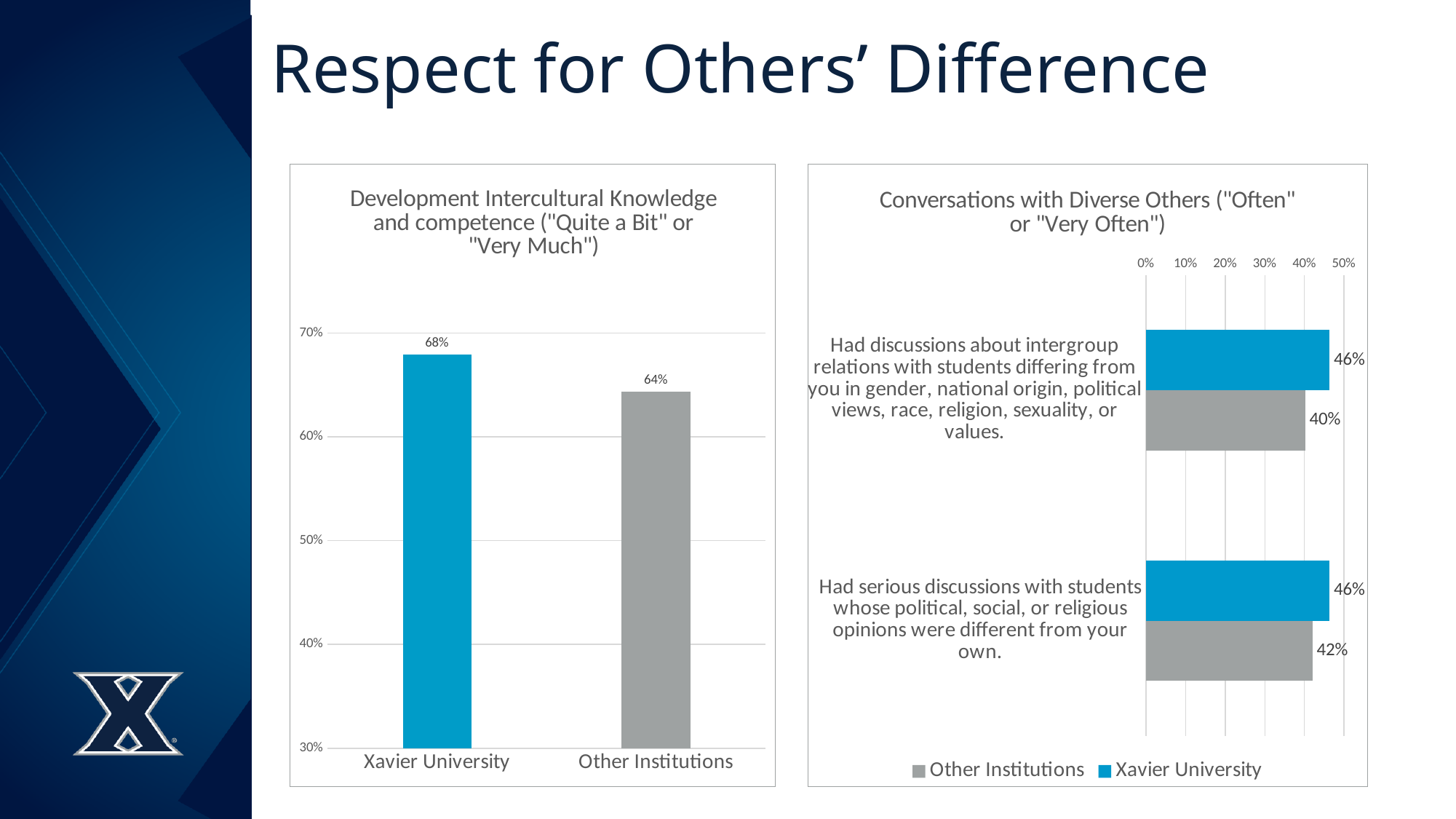
In the right chart (Conversations with Diverse Others), how many series does the legend list? 2 In the right chart (Conversations with Diverse Others), what is the Other Institutions value for 'Had serious discussions with students whose political, social, or religious opinions were different from your own'? 42% In the left chart (Development Intercultural Knowledge and competence), how many categories are shown? 2 In the right chart (Conversations with Diverse Others), which series has the larger value for 'Had serious discussions with students whose political, social, or religious opinions were different from your own'? Xavier University In the left chart (Development Intercultural Knowledge and competence), what is the difference between Xavier University and Other Institutions? 4% In the left chart (Development Intercultural Knowledge and competence), what is the value for Xavier University? 68% In the left chart (Development Intercultural Knowledge and competence), which category has the higher value? Xavier University In the right chart (Conversations with Diverse Others), what colour are the Xavier University bars? Blue In the right chart (Conversations with Diverse Others), what is the difference between Xavier University and Other Institutions for 'Had discussions about intergroup relations with students differing from you...'? 6% In the right chart (Conversations with Diverse Others), what is the Xavier University value for 'Had discussions about intergroup relations with students differing from you in gender, national origin, political views, race, religion, sexuality, or values'? 46% In the left chart (Development Intercultural Knowledge and competence), what is the value for Other Institutions? 64% What kind of chart is the left chart (Development Intercultural Knowledge and competence)? Bar chart